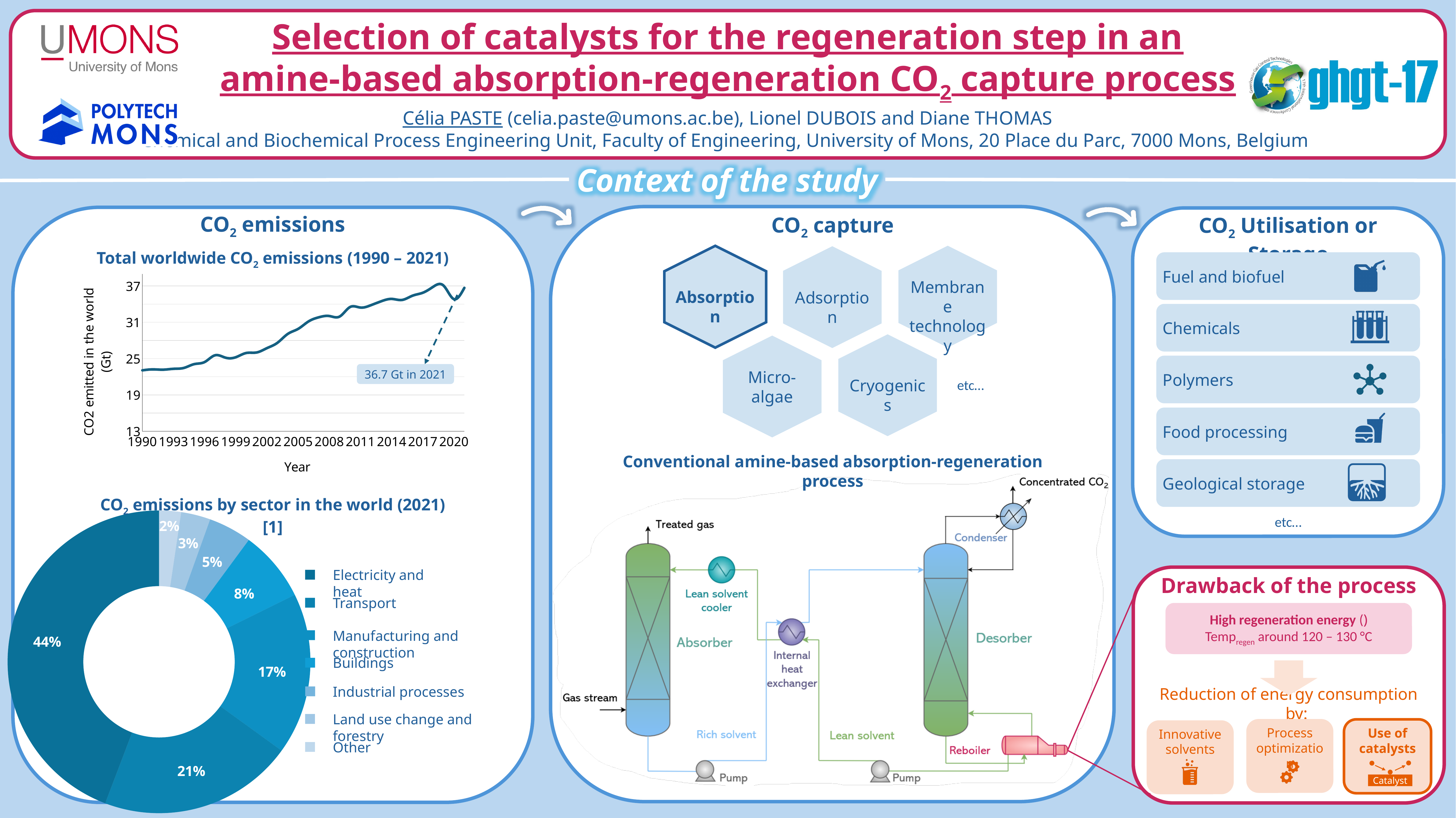
What kind of chart is 'Total worldwide CO2 emissions (1990 – 2021)'? line chart How many sectors does the legend of the 'CO2 emissions by sector in the world (2021)' chart list? 7 In the 'CO2 emissions by sector in the world (2021)' chart, what is the difference between the Transport and Manufacturing and construction shares? 4% In the 'CO2 emissions by sector in the world (2021)' chart, what share is Electricity and heat? 44% In the 'CO2 emissions by sector in the world (2021)' chart, what share is Transport? 21% In the 'Total worldwide CO2 emissions (1990 – 2021)' chart, what value is labelled for 2021? 36.7 Gt In the 'Total worldwide CO2 emissions (1990 – 2021)' chart, do emissions generally rise or fall from 1990 to 2021? rise In the 'Total worldwide CO2 emissions (1990 – 2021)' chart, is the value for 2011 greater or less than 31? greater In the 'CO2 emissions by sector in the world (2021)' chart, which sector has the smallest share? Other What kind of chart is 'CO2 emissions by sector in the world (2021)'? doughnut chart In the 'CO2 emissions by sector in the world (2021)' chart, which sector has the largest share? Electricity and heat In the 'Total worldwide CO2 emissions (1990 – 2021)' chart, is the value for 1990 greater or less than 25? less